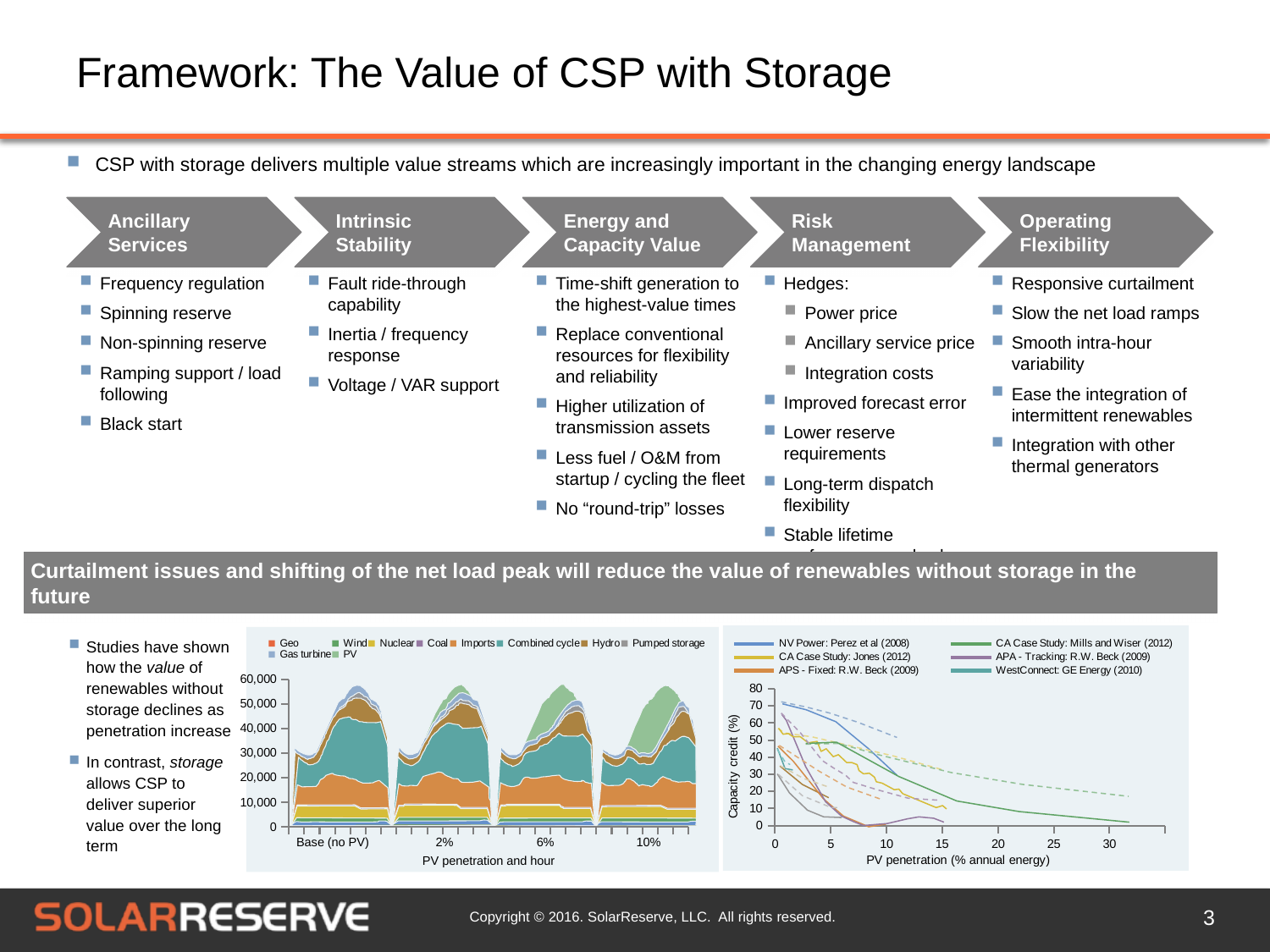
In the right chart (Capacity credit), does the capacity credit rise or fall as PV penetration increases along the x axis? fall In the right chart (Capacity credit), is the value of the CA Case Study: Mills and Wiser (2012) line at 30% PV penetration greater or less than 10? less What kind of chart is the chart on the right at the bottom of the slide (Capacity credit vs PV penetration)? line chart In the left chart (PV penetration and hour), what is the highest value shown on the y axis? 60,000 What is the x-axis title of the right chart (Capacity credit)? PV penetration (% annual energy) In the right chart (Capacity credit), how many series does the legend list? 6 What kind of chart is the chart on the left at the bottom of the slide (PV penetration and hour)? stacked area chart In the left chart (PV penetration and hour), how many series does the legend list? 10 In the right chart (Capacity credit), is the starting value of the NV Power: Perez et al (2008) line at 0% PV penetration greater or less than 60? greater In the left chart (PV penetration and hour), is the peak of the stacked total in the Base (no PV) section greater or less than 50,000? greater In the left chart (PV penetration and hour), how many PV penetration categories are labelled on the x axis? 4